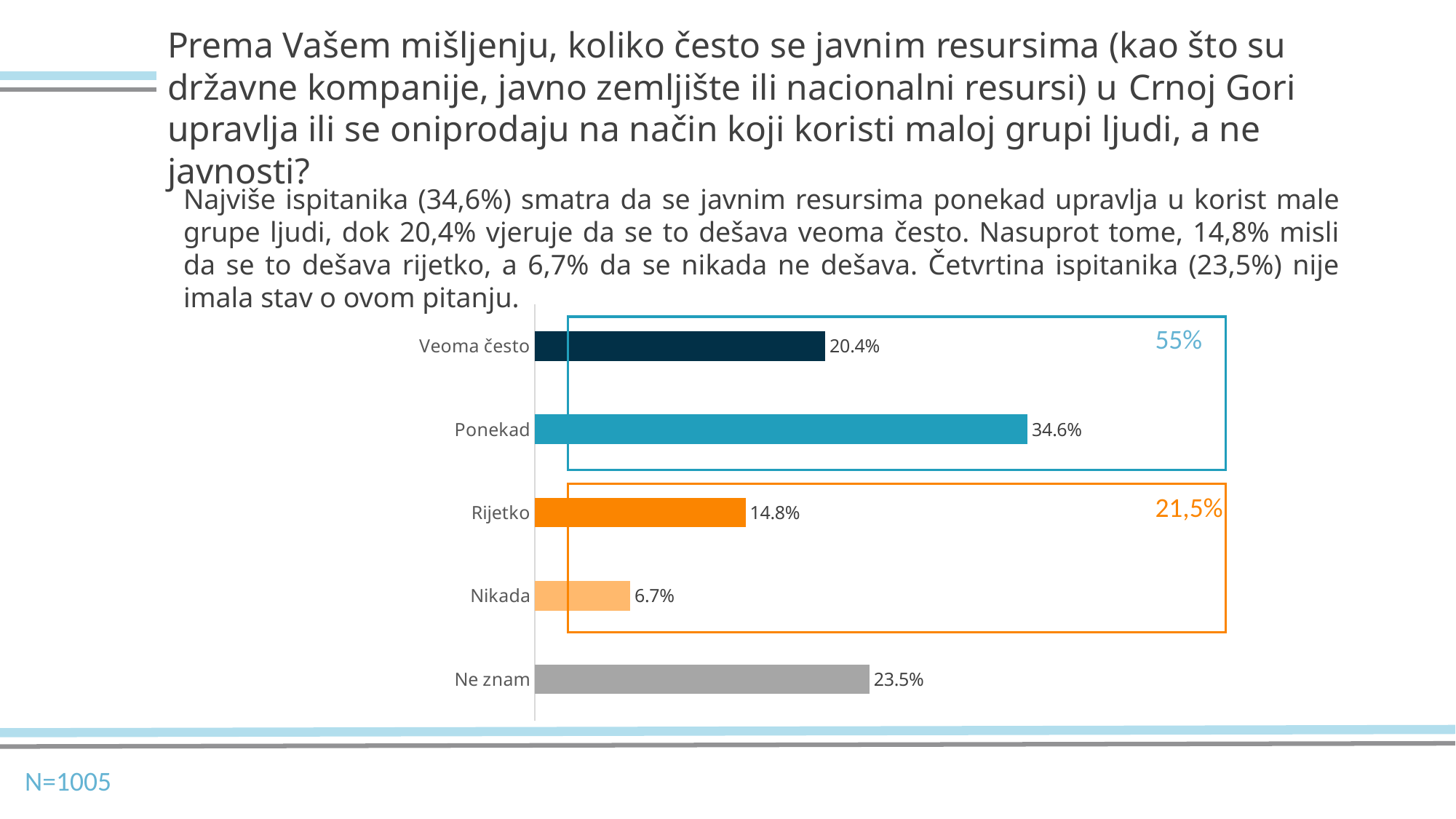
What is the value for Ne znam? 23.5% What is the value for Nikada? 6.7% What is the value for Ponekad? 34.6% What is the value for Veoma često? 20.4% What kind of chart is shown on the slide? Bar chart What combined percentage is shown in the box grouping Veoma često and Ponekad? 55% Which category has the lowest value? Nikada Which category has the highest value? Ponekad How many categories are shown in the chart? 5 What is the difference between the values for Ponekad and Veoma često? 14.2% Which is larger, the value for Ne znam or the value for Rijetko? Ne znam What is the value for Rijetko? 14.8%